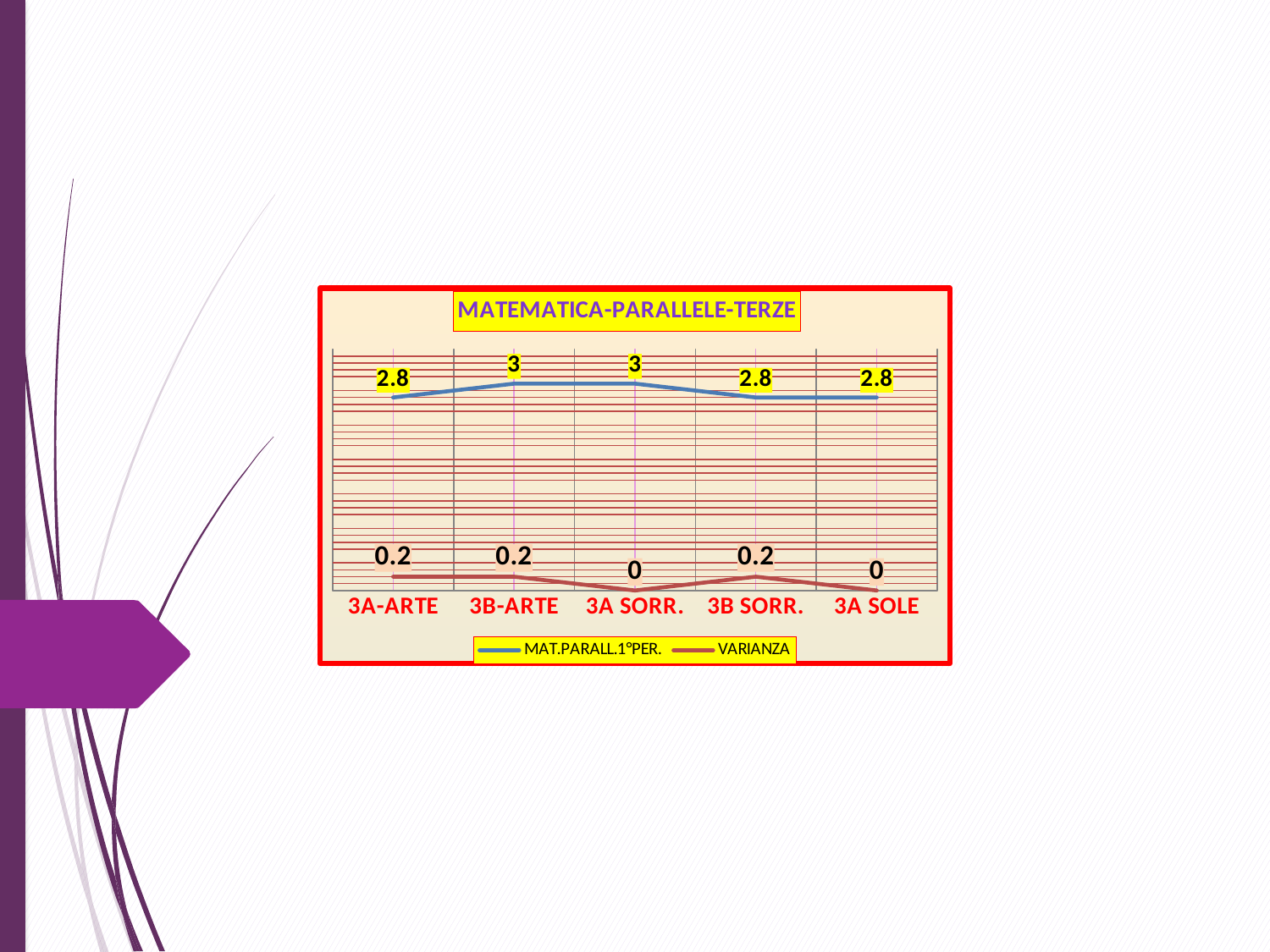
Which categories have the highest MAT.PARALL.1°PER. value? 3B-ARTE and 3A SORR. How many categories are shown on the x axis? 5 What is the difference between the MAT.PARALL.1°PER. values for 3B-ARTE and 3A-ARTE? 0.2 What is the MAT.PARALL.1°PER. value for 3A SOLE? 2.8 What is the VARIANZA value for 3A SORR.? 0 How many series does the legend list? 2 What is the MAT.PARALL.1°PER. value for 3B-ARTE? 3 Which categories have the lowest VARIANZA value? 3A SORR. and 3A SOLE What is the title of the chart? MATEMATICA-PARALLELE-TERZE Which is larger, the MAT.PARALL.1°PER. value for 3A SORR. or for 3B SORR.? 3A SORR. What is the VARIANZA value for 3B SORR.? 0.2 What kind of chart is shown? Line chart